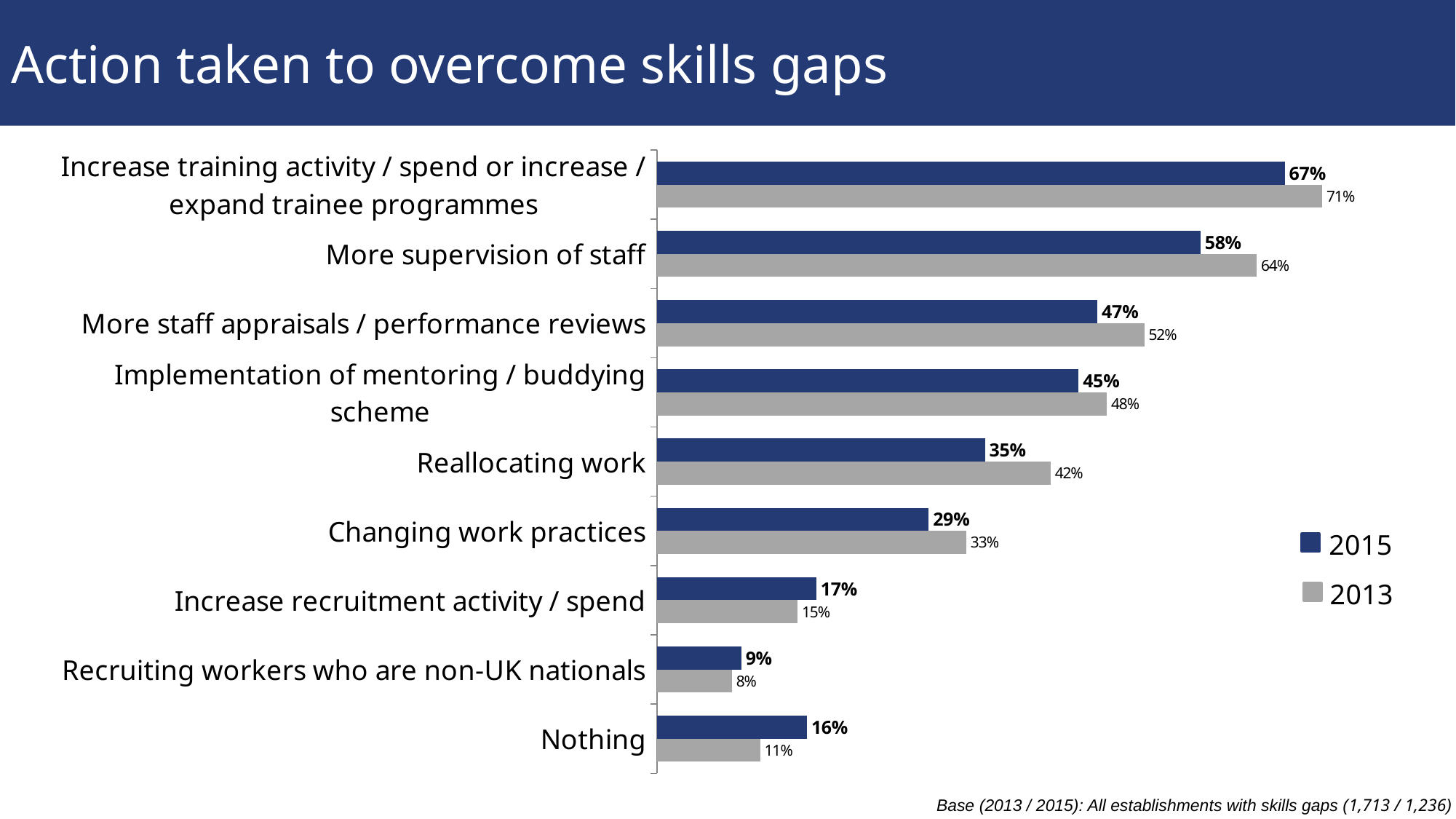
How many categories are shown on the chart? 9 Which colour represents the 2013 series in the legend? Grey What is the difference between the 2013 and 2015 values for 'Reallocating work'? 7 percentage points What kind of chart is shown on the slide? Bar chart What is the 2015 value for 'Nothing'? 16% Which is larger for 'More staff appraisals / performance reviews': the 2015 value or the 2013 value? 2013 Which category has the lowest 2013 value? Recruiting workers who are non-UK nationals Which category has the highest 2015 value? Increase training activity / spend or increase / expand trainee programmes How many series does the legend list? 2 What is the 2015 value for 'More supervision of staff'? 58% Which is larger for 'Increase recruitment activity / spend': the 2015 value or the 2013 value? 2015 What is the 2013 value for 'Reallocating work'? 42%